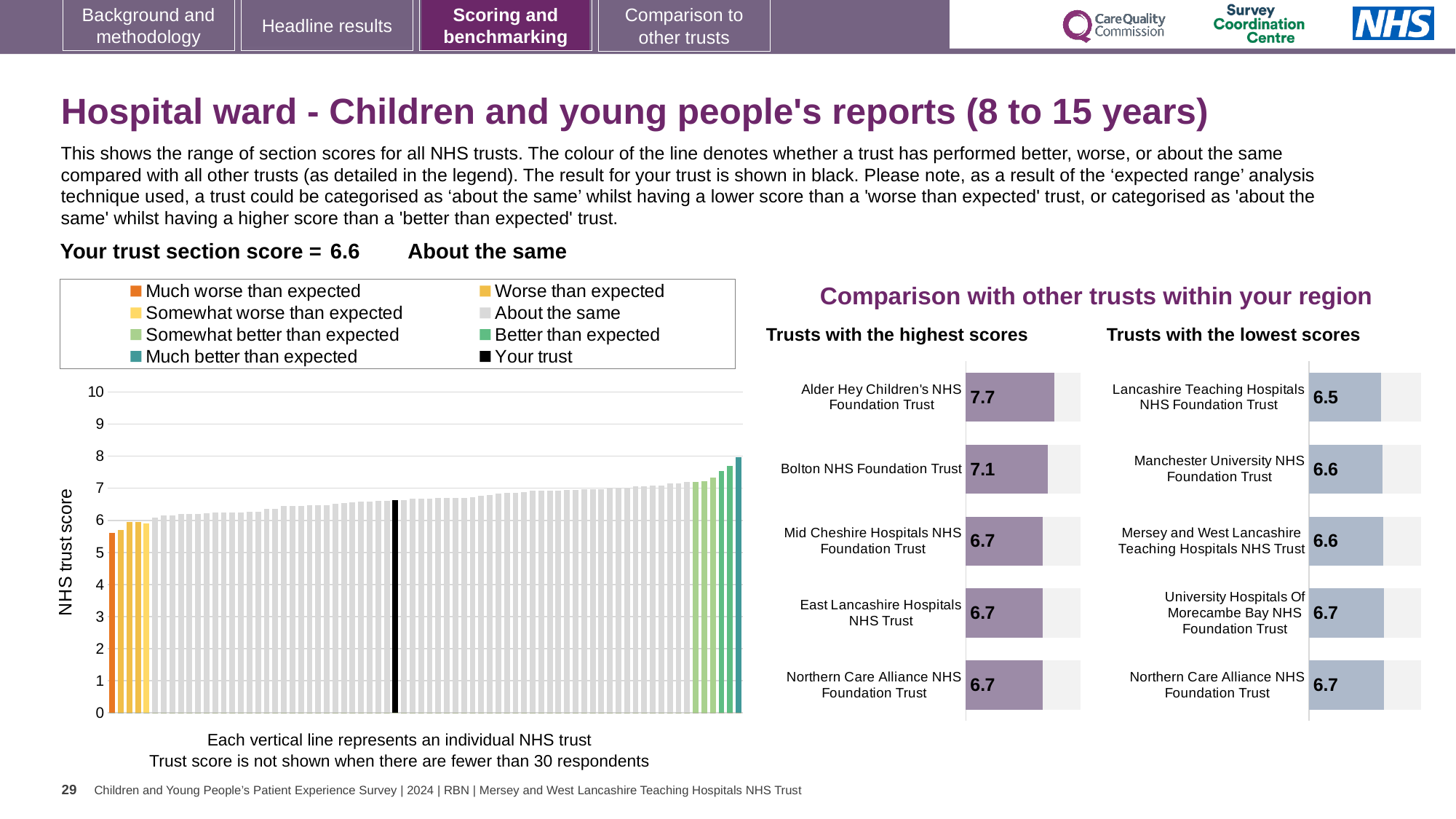
In the 'Trusts with the highest scores' chart, which trust has the highest score? Alder Hey Children's NHS Foundation Trust In the 'Trusts with the highest scores' chart, what is the score for Bolton NHS Foundation Trust? 7.1 In the 'Trusts with the highest scores' chart, what is the score for Alder Hey Children's NHS Foundation Trust? 7.7 In the 'Trusts with the highest scores' chart, what is the difference between the scores of Alder Hey Children's NHS Foundation Trust and Bolton NHS Foundation Trust? 0.6 In the 'Trusts with the lowest scores' chart, what is the score for Manchester University NHS Foundation Trust? 6.6 In the NHS trust score chart on the left, do the bar values rise or fall from left to right? Rise In the 'Trusts with the lowest scores' chart, which trust has the lowest score? Lancashire Teaching Hospitals NHS Foundation Trust In the NHS trust score chart on the left, how many entries does the legend list? 8 How many trusts are listed in the 'Trusts with the highest scores' chart? 5 What kind of chart is the NHS trust score chart on the left? Bar chart In the 'Trusts with the lowest scores' chart, what is the score for Lancashire Teaching Hospitals NHS Foundation Trust? 6.5 In the 'Trusts with the lowest scores' chart, which has the larger score: University Hospitals Of Morecambe Bay NHS Foundation Trust or Lancashire Teaching Hospitals NHS Foundation Trust? University Hospitals Of Morecambe Bay NHS Foundation Trust